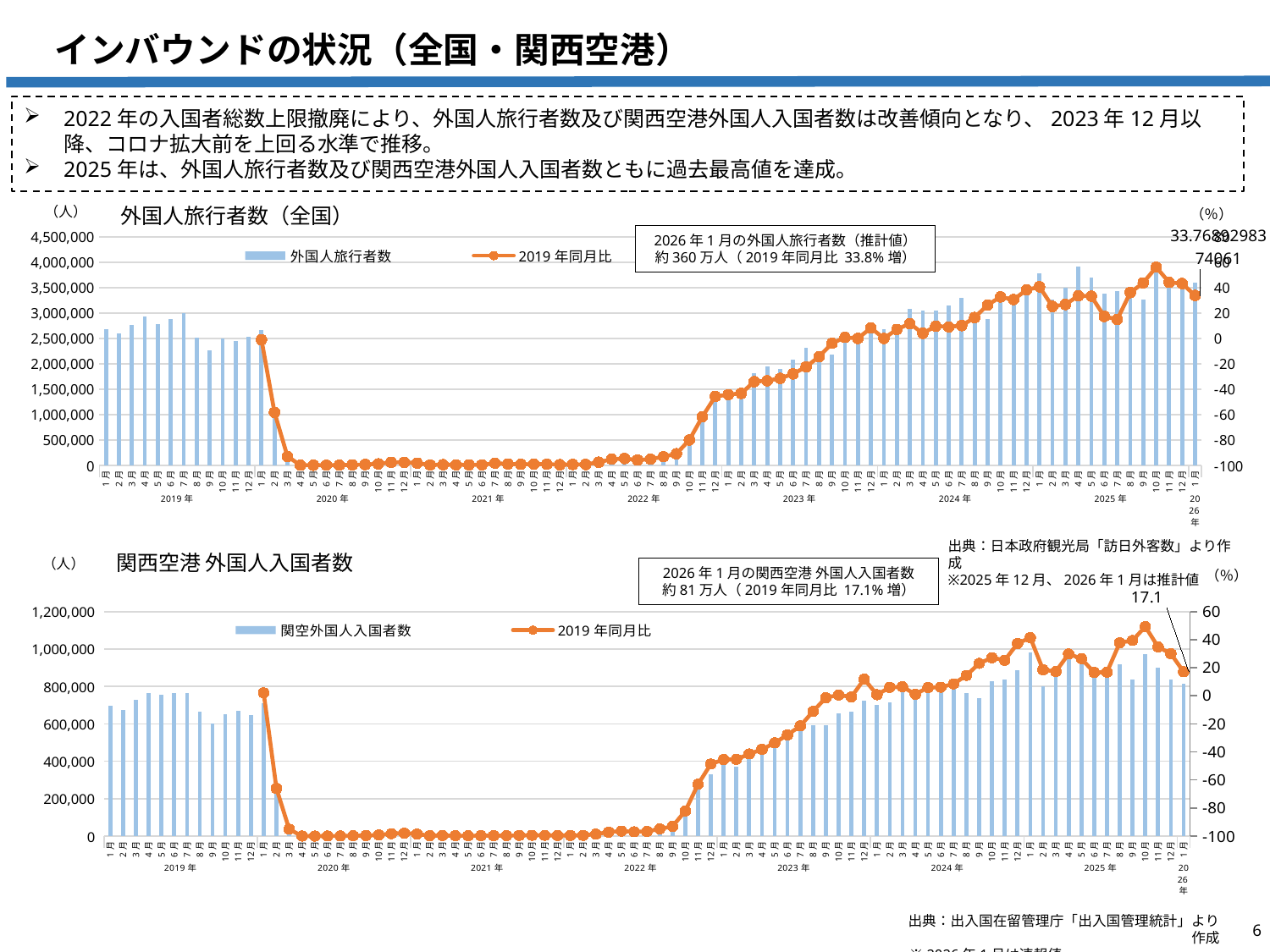
In the bottom chart (関西空港 外国人入国者数), what is the 2019年同月比 value labelled for 2026年1月? 17.1 In the top chart (外国人旅行者数（全国）), is the bar for 2020年5月 greater or less than 500,000? less In the bottom chart (関西空港 外国人入国者数), what unit is shown on the right-hand axis? % How many series does the legend of the top chart (外国人旅行者数（全国）) list? 2 How many series does the legend of the bottom chart (関西空港 外国人入国者数) list? 2 In the bottom chart (関西空港 外国人入国者数), does the 2019年同月比 line rise or fall from 2020年1月 to 2020年4月? fall In the bottom chart (関西空港 外国人入国者数), is the bar for 2021年1月 greater or less than 200,000? less In the top chart (外国人旅行者数（全国）), which series is drawn as bars? 外国人旅行者数 In the top chart (外国人旅行者数（全国）), which bar is larger: 2019年1月 or 2021年1月? 2019年1月 What kind of chart is the top chart titled 外国人旅行者数（全国）? A combined bar and line chart In the bottom chart (関西空港 外国人入国者数), is the bar for 2019年1月 greater or less than 600,000? greater